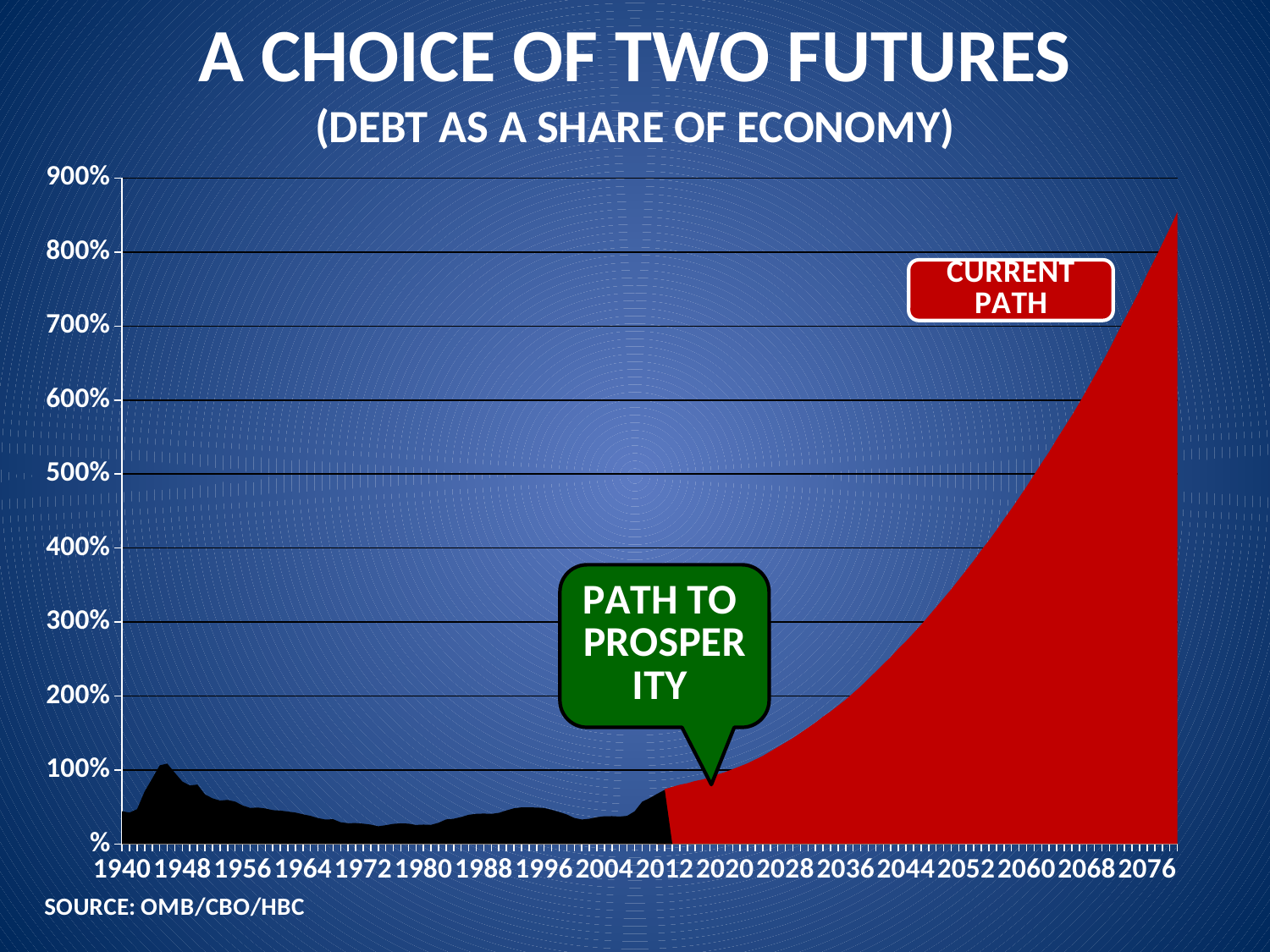
Does the current path rise or fall from 2012 to 2076? Rises Is the value of the current path at 2044 greater or less than 300%? less What kind of chart is shown on the slide? Area chart What is the title of the chart? A CHOICE OF TWO FUTURES (DEBT AS A SHARE OF ECONOMY) How many year labels are shown on the horizontal axis? 18 What source is cited for the chart? OMB/CBO/HBC What is the last year labelled on the horizontal axis? 2076 Is the value of the current path at 2068 greater or less than 500%? greater What is the first year labelled on the horizontal axis? 1940 Is the value of the current path at 2044 greater or less than 400%? less What is the highest value shown on the vertical axis? 900% Does the debt share rise or fall from 1948 to 1980? Falls